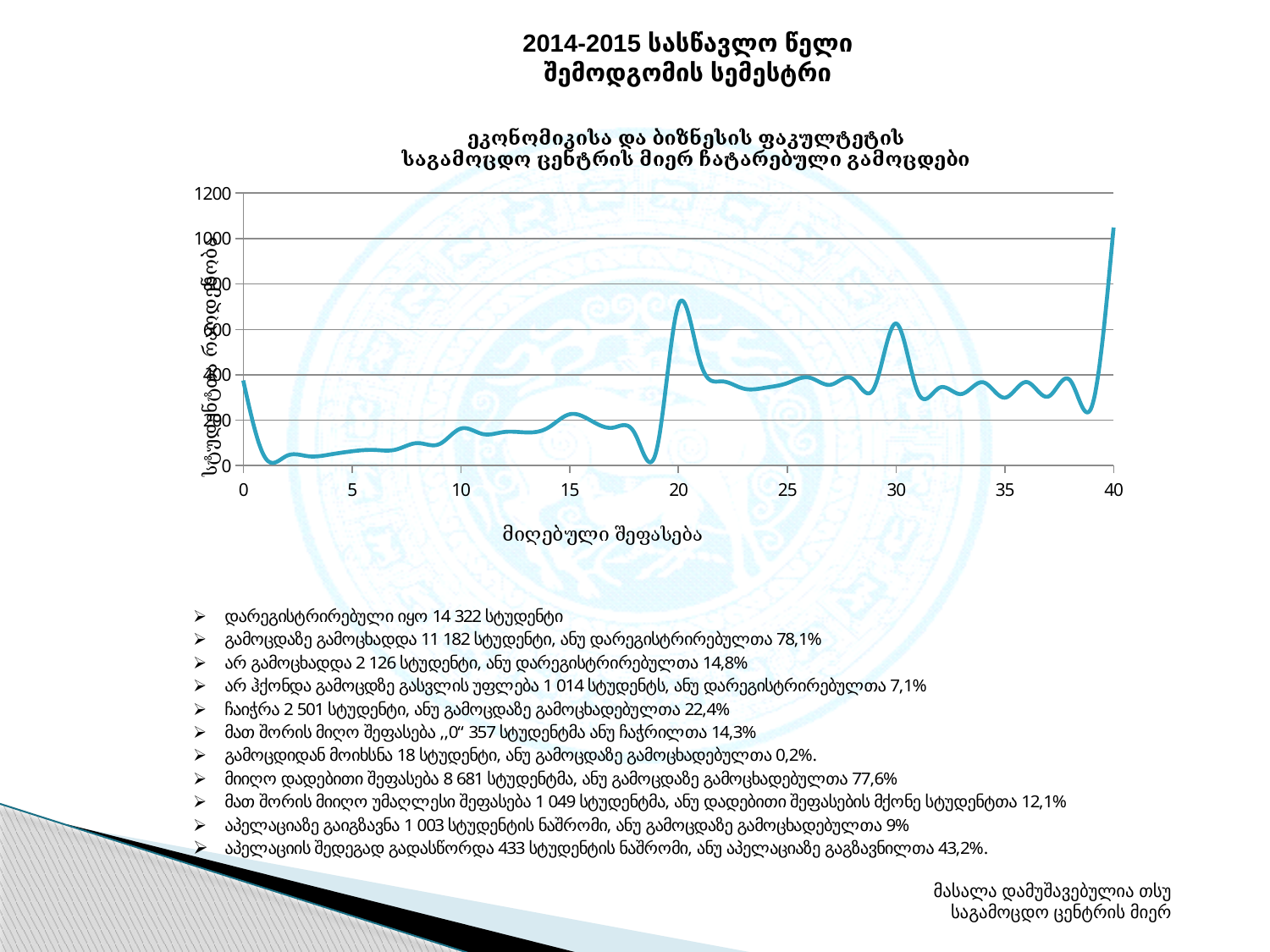
Does the line rise or fall between scores 0 and 1? fall Is the value at a score of 5 greater or less than 200? less What is the title of the x axis of the chart? მიღებული შეფასება Is the value at a score of 40 greater or less than 800? greater At which score on the x axis does the line reach its highest value? 40 Is the value at a score of 15 greater or less than 400? less What is the highest value shown on the y axis of the chart? 1200 What kind of chart is shown on the slide? line chart Which is larger, the value at a score of 20 or the value at a score of 30? score of 20